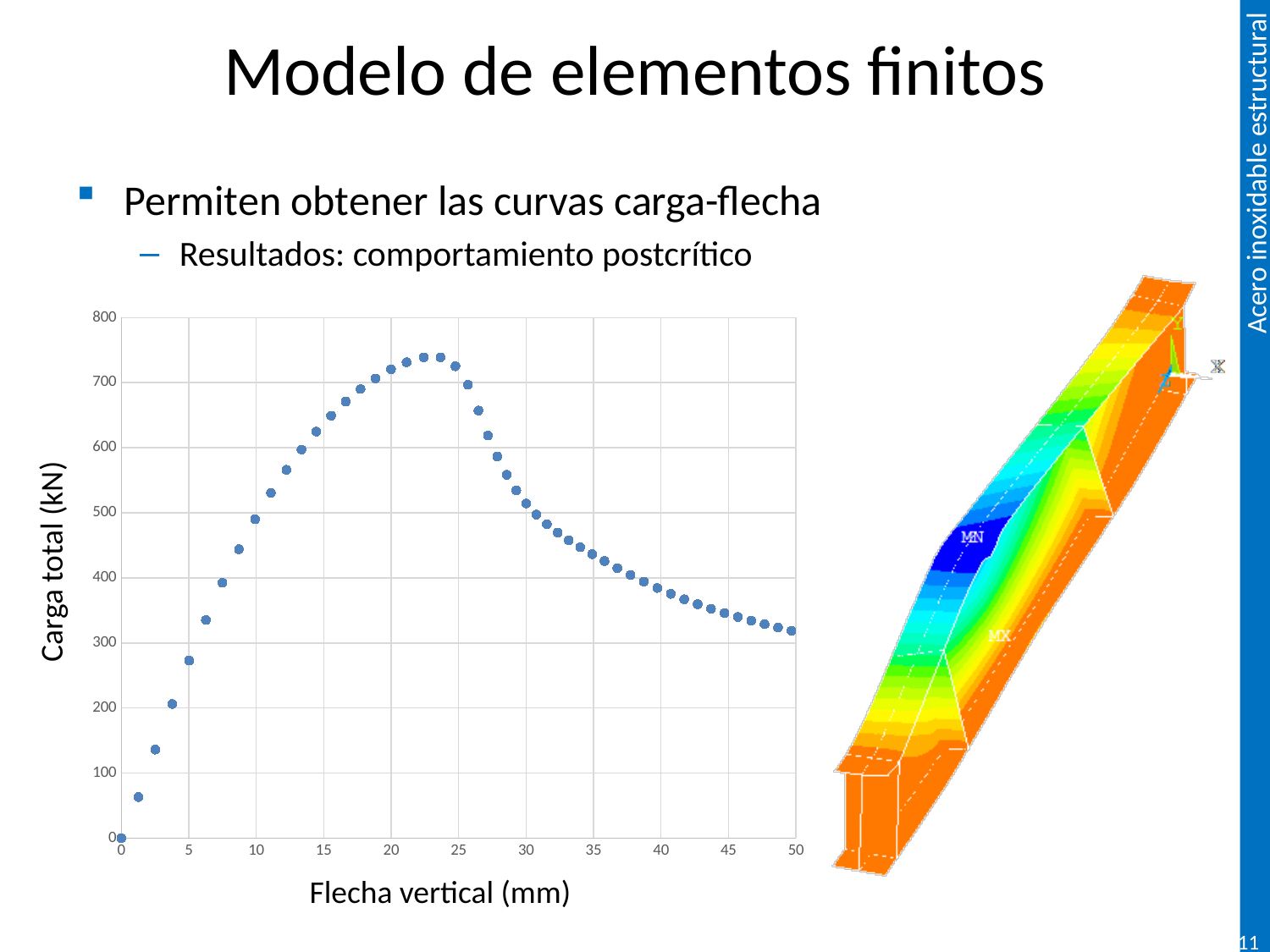
What kind of chart is shown on the slide? scatter chart Does the load rise or fall as the vertical deflection increases from 30 to 50 mm? falls Is the load at a vertical deflection of 50 mm greater or less than 300 kN? greater Does the load rise or fall as the vertical deflection increases from 0 to 20 mm? rises Is the peak load reached by the curve greater or less than 800 kN? less What is the title of the vertical axis of the chart? Carga total (kN) Is the load at a vertical deflection of 5 mm greater or less than 300 kN? less What is the title of the horizontal axis of the chart? Flecha vertical (mm)